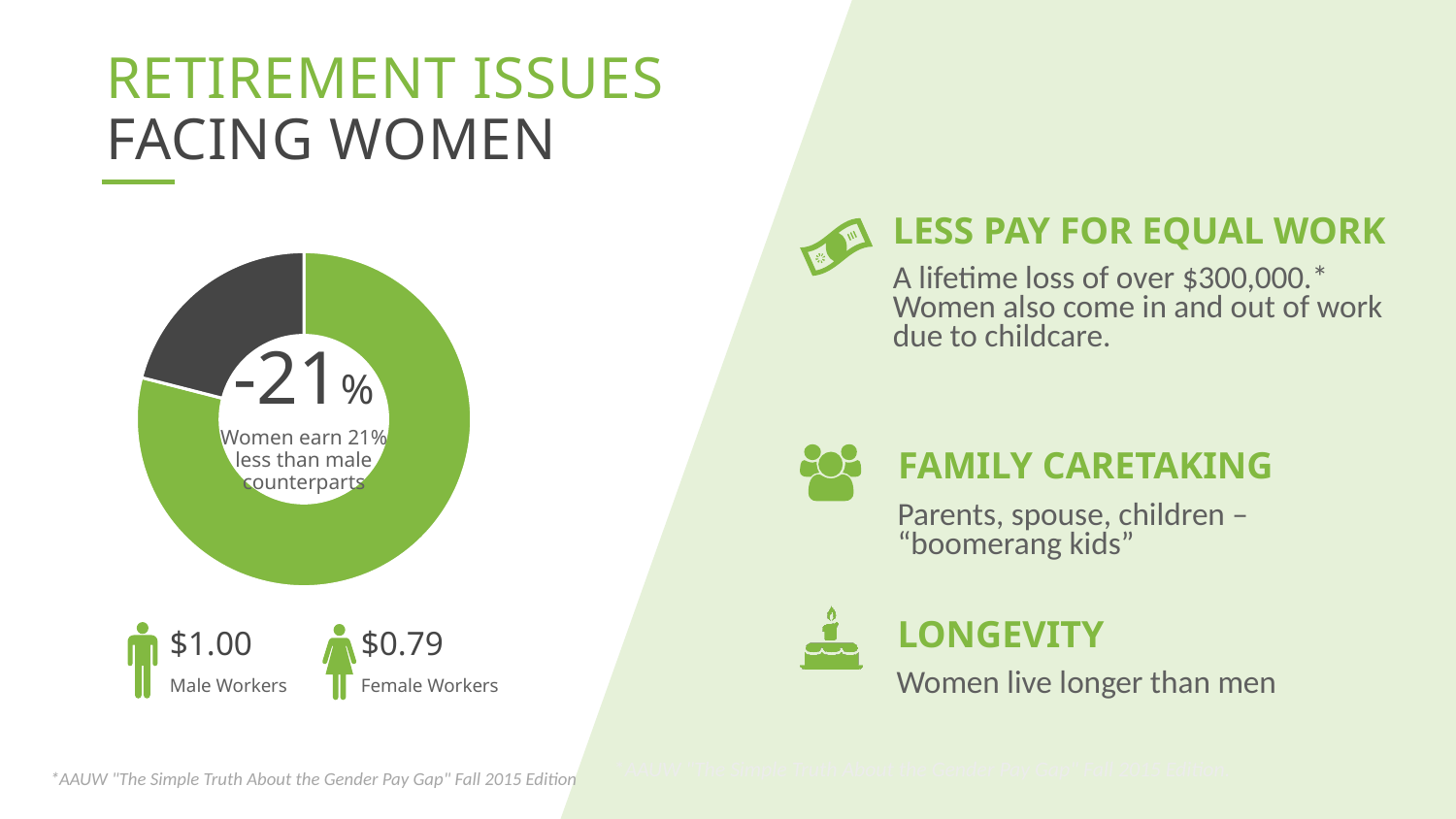
How many slices does the donut chart have? 2 Which group is shown with the higher amount, Male Workers or Female Workers? Male Workers According to the text inside the donut chart, how much less do women earn than their male counterparts? 21% What value is printed in the centre of the donut chart? -21% What is the difference between the amount shown for Male Workers and the amount shown for Female Workers? $0.21 What amount is shown for Male Workers below the chart? $1.00 What kind of chart is shown on the left of the slide? Pie chart (donut) What colour is the larger slice of the donut chart? Green Which slice of the donut chart is larger, the green one or the dark grey one? The green one Is the dark grey slice of the donut chart greater or less than 50% of the whole? less What source is cited in the footnote for the pay gap figure? AAUW "The Simple Truth About the Gender Pay Gap" Fall 2015 Edition What amount is shown for Female Workers below the chart? $0.79